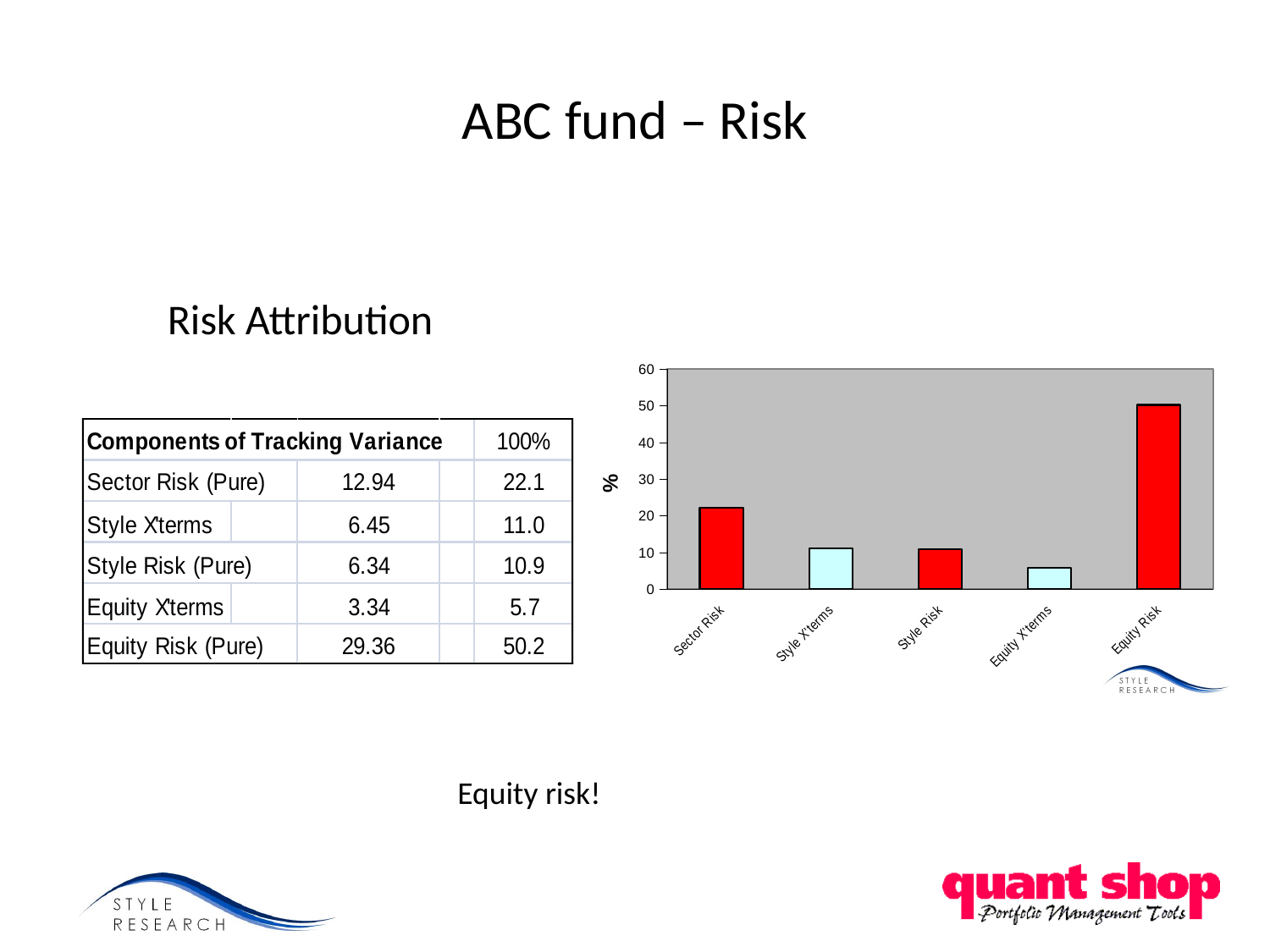
What is the highest tick value shown on the y axis of the chart? 60 Which is larger in the chart, Equity Risk or Sector Risk? Equity Risk Is the value for Sector Risk greater or less than 20? greater How many categories are plotted on the x axis of the chart? 5 Is the value for Equity Risk greater or less than 40? greater What kind of chart is shown on the slide? bar chart Which category has the lowest bar in the chart? Equity X'terms Which is larger in the chart, Sector Risk or Style Risk? Sector Risk Which category has the highest bar in the chart? Equity Risk Is the value for Style Risk greater or less than 20? less What is the label on the y axis of the chart? %